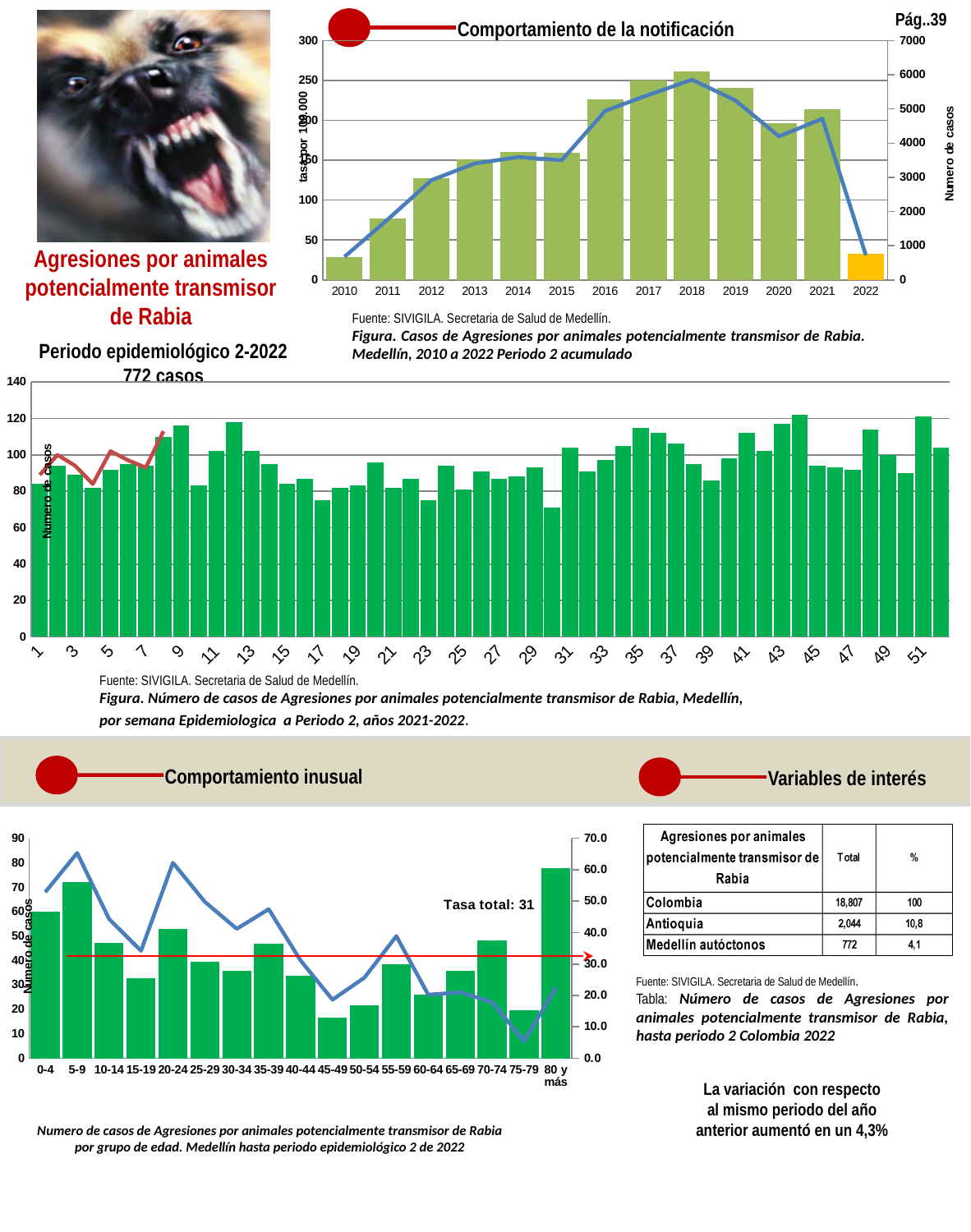
In the 'Comportamiento de la notificación' chart, is the number of cases bar for 2018 greater or less than 5000? greater In the age-group chart at the bottom left, what is the 'Tasa total' printed on the chart? 31 In the weekly chart (cases by epidemiological week), which bar is taller, week 11 or week 17? week 11 In the 'Comportamiento de la notificación' chart, do the bars rise or fall from 2018 to 2022? fall In the 'Comportamiento de la notificación' chart, which bar is taller, 2012 or 2016? 2016 In the weekly chart (cases by epidemiological week), is the value for week 30 greater or less than 80? less In the 'Comportamiento de la notificación' chart, is the number of cases bar for 2010 greater or less than 1000? less In the 'Comportamiento de la notificación' chart, which year has the tallest bar? 2018 In the weekly chart (cases by epidemiological week), which week has the lowest bar? 30 In the age-group chart at the bottom left, which age group has the tallest bar? 80 y más In the 'Comportamiento de la notificación' chart, how many years are shown on the x axis? 13